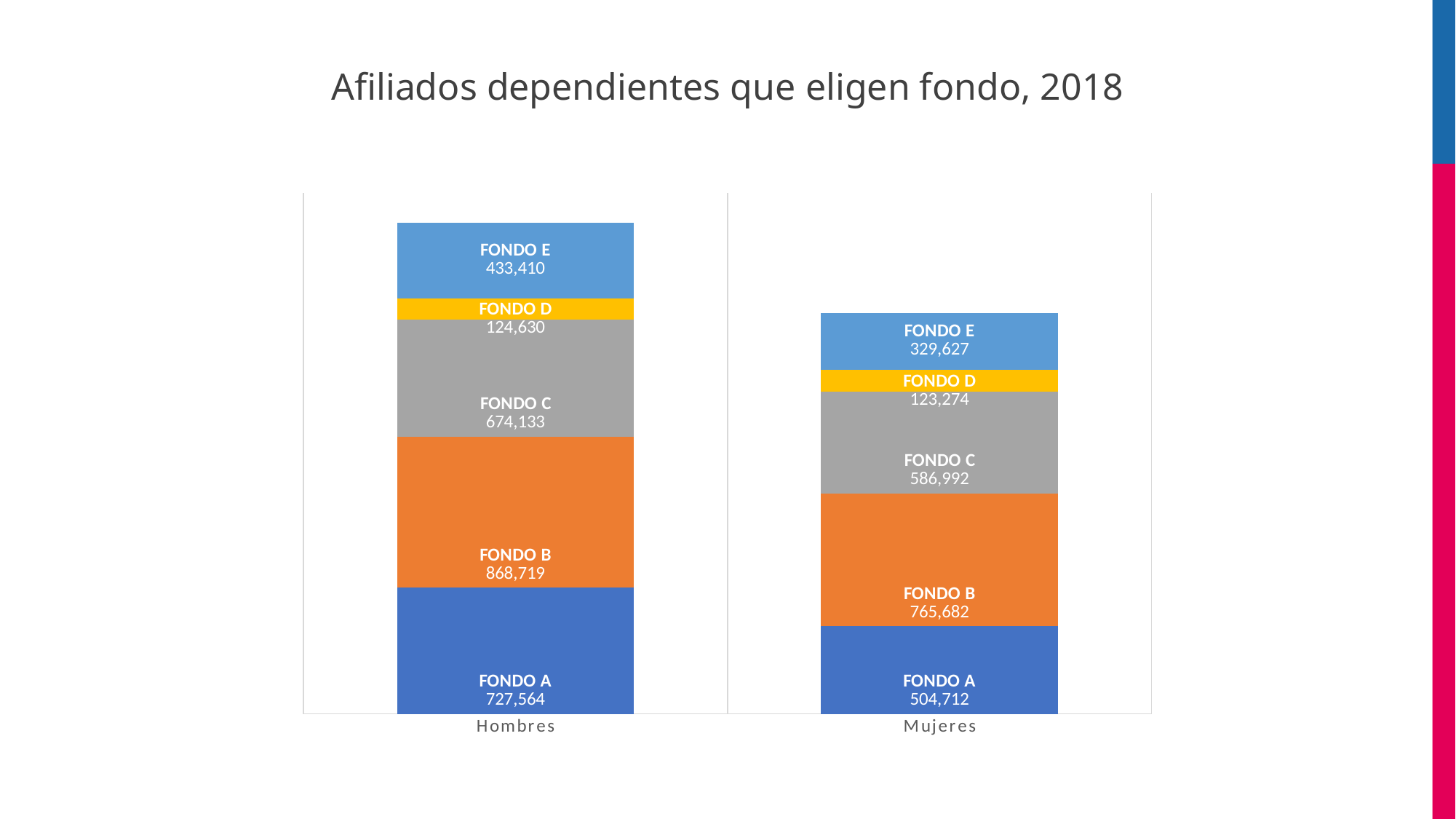
How many categories are shown on the x axis? 2 What is the difference between the Fondo A values for Hombres and Mujeres? 222,852 What is the value for Fondo A in the Hombres bar? 727,564 Which fondo has the largest value in the Hombres bar? Fondo B What is the value for Fondo D in the Hombres bar? 124,630 What is the value for Fondo E in the Mujeres bar? 329,627 Which is larger, Fondo C for Hombres or Fondo C for Mujeres? Fondo C for Hombres Which fondo has the smallest value in the Mujeres bar? Fondo D What is the value for Fondo C in the Mujeres bar? 586,992 What kind of chart is shown on the slide? Stacked bar chart What is the difference between the Fondo B values for Hombres and Mujeres? 103,037 What is the total of the Mujeres stacked bar? 2,310,287